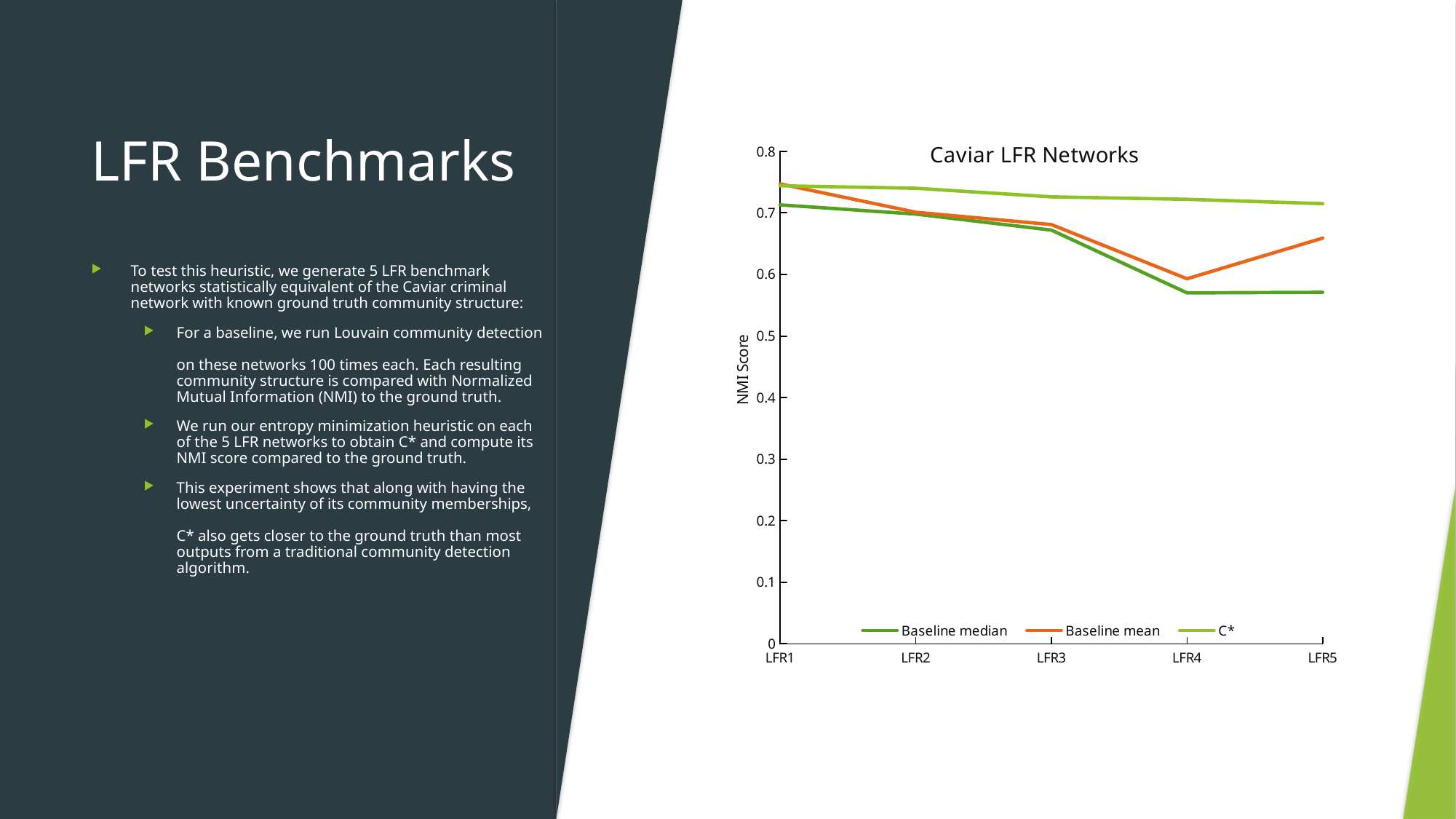
What kind of chart is shown on the slide? Line chart Which series has the highest value at LFR4? C* At LFR5, which is larger: Baseline mean or Baseline median? Baseline mean Is the Baseline mean value for LFR5 greater or less than 0.7? less How many series does the legend list? 3 Is the C* value for LFR5 greater or less than 0.7? greater Which series has the lowest value at LFR5? Baseline median What is the label of the vertical axis? NMI Score At which LFR network is the Baseline mean lowest? LFR4 What is the title of the chart? Caviar LFR Networks How many LFR networks are plotted along the x axis? 5 Is the Baseline median value for LFR4 greater or less than 0.6? less